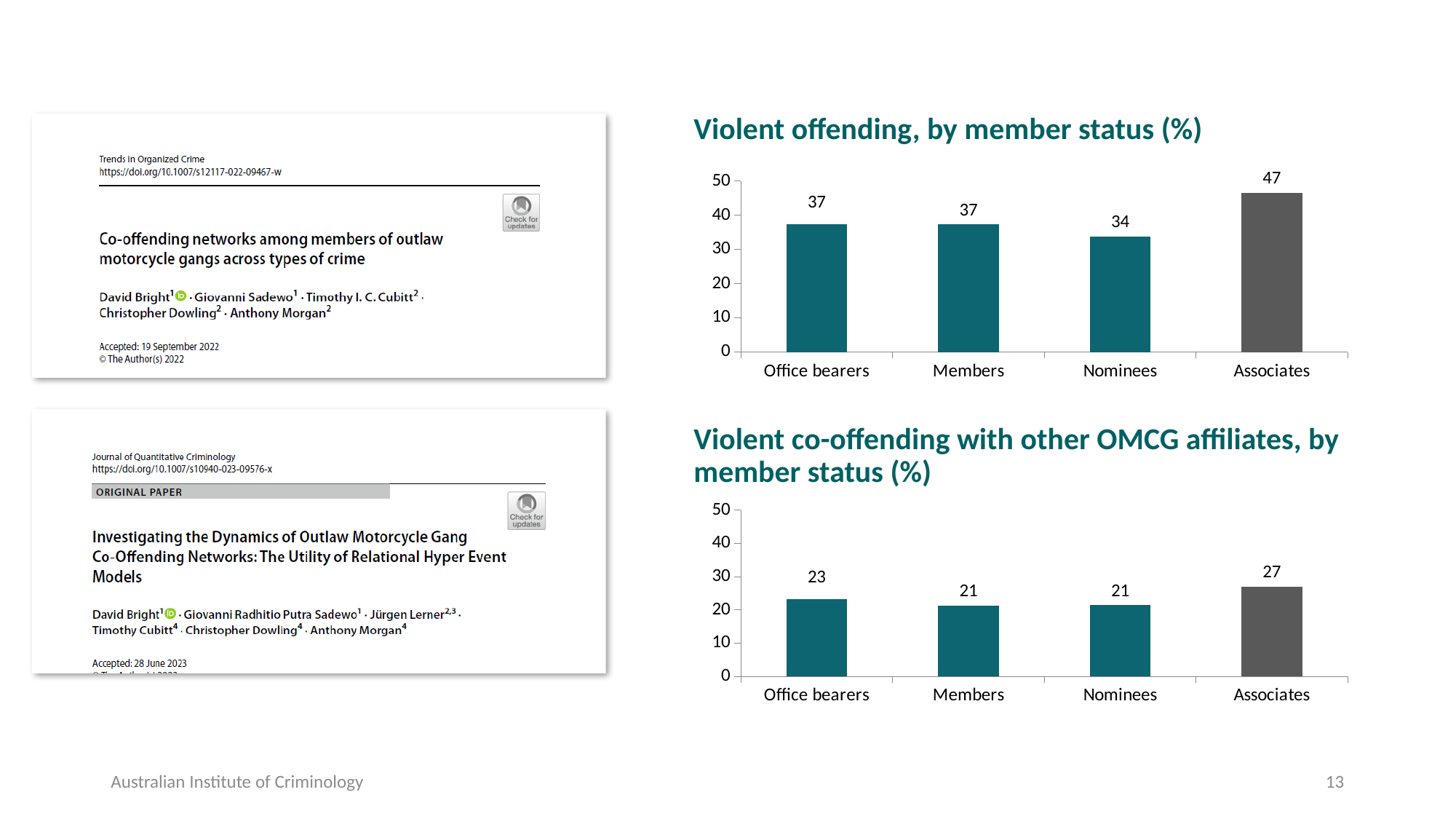
In the 'Violent co-offending with other OMCG affiliates, by member status (%)' chart, which category has the highest value? Associates In the 'Violent co-offending with other OMCG affiliates, by member status (%)' chart, what is the value for Office bearers? 23 In the 'Violent offending, by member status (%)' chart, what is the value for Nominees? 34 In the 'Violent offending, by member status (%)' chart, what is the difference between Associates and Nominees? 13 In the 'Violent offending, by member status (%)' chart, which category has the lowest value? Nominees What kind of chart is the 'Violent offending, by member status (%)' chart? bar chart In the 'Violent co-offending with other OMCG affiliates, by member status (%)' chart, what is the difference between Associates and Members? 6 In the 'Violent offending, by member status (%)' chart, how many categories are shown? 4 In the 'Violent co-offending with other OMCG affiliates, by member status (%)' chart, which bar is coloured dark grey rather than teal? Associates In the 'Violent offending, by member status (%)' chart, is the value for Associates greater or less than 40? greater In the 'Violent co-offending with other OMCG affiliates, by member status (%)' chart, is the value for Office bearers larger or smaller than the value for Nominees? larger In the 'Violent offending, by member status (%)' chart, what is the value for Associates? 47